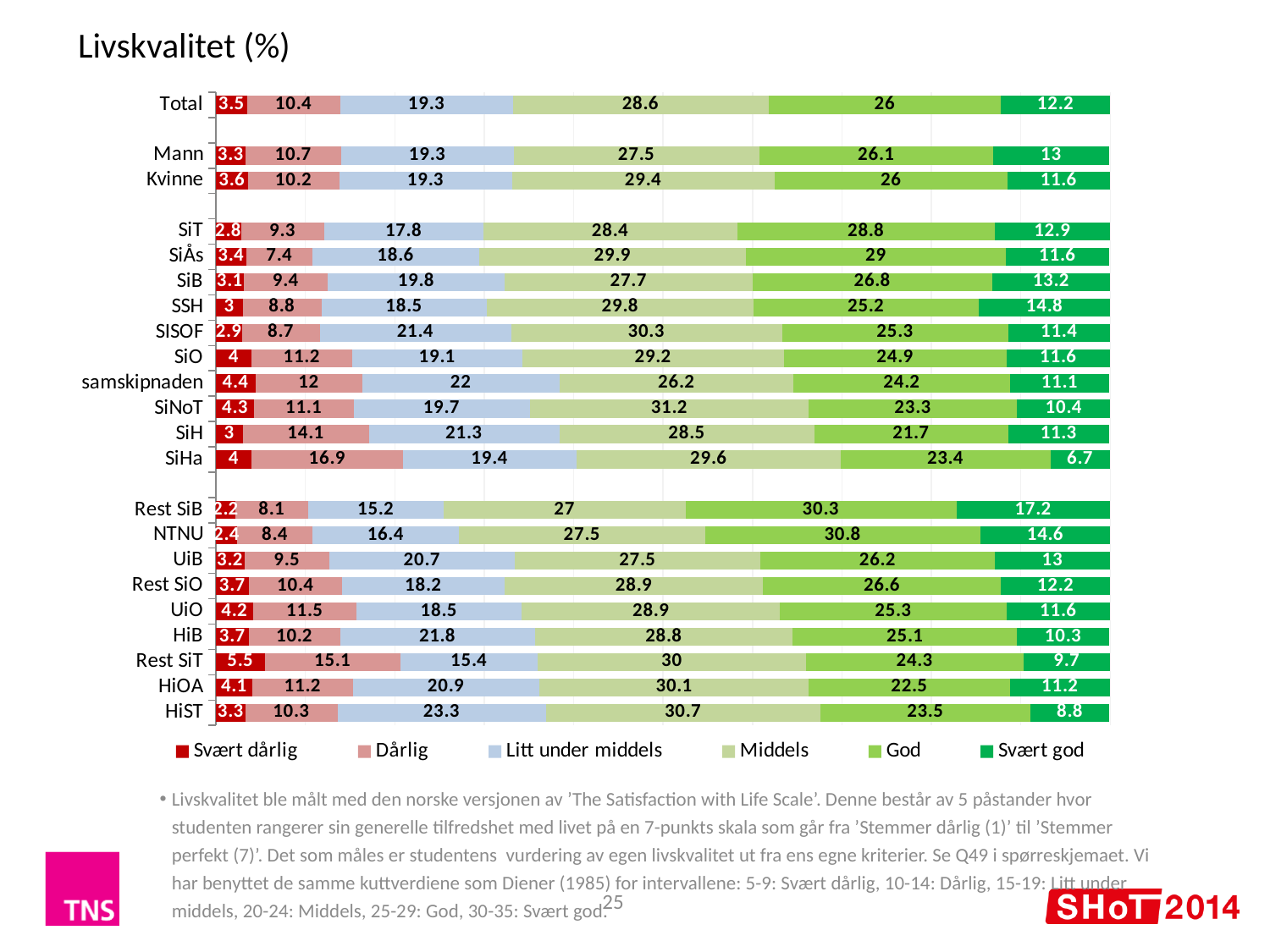
How many categories are shown on the y axis? 22 Which category has the highest Dårlig value? SiHa What is the Svært god value for SiHa? 6.7 What is the value of the Middels segment for Total? 28.6 Which category has the lowest Svært god value? SiHa Which has a larger God value, NTNU or UiO? NTNU What kind of chart is this? Stacked bar chart What is the Svært dårlig value for Rest SiT? 5.5 How many series does the legend list? 6 What is the difference between the Svært god values for Mann and Kvinne? 1.4 Which category has the highest Svært god value? Rest SiB What is the total of the stacked bar for Total? 100